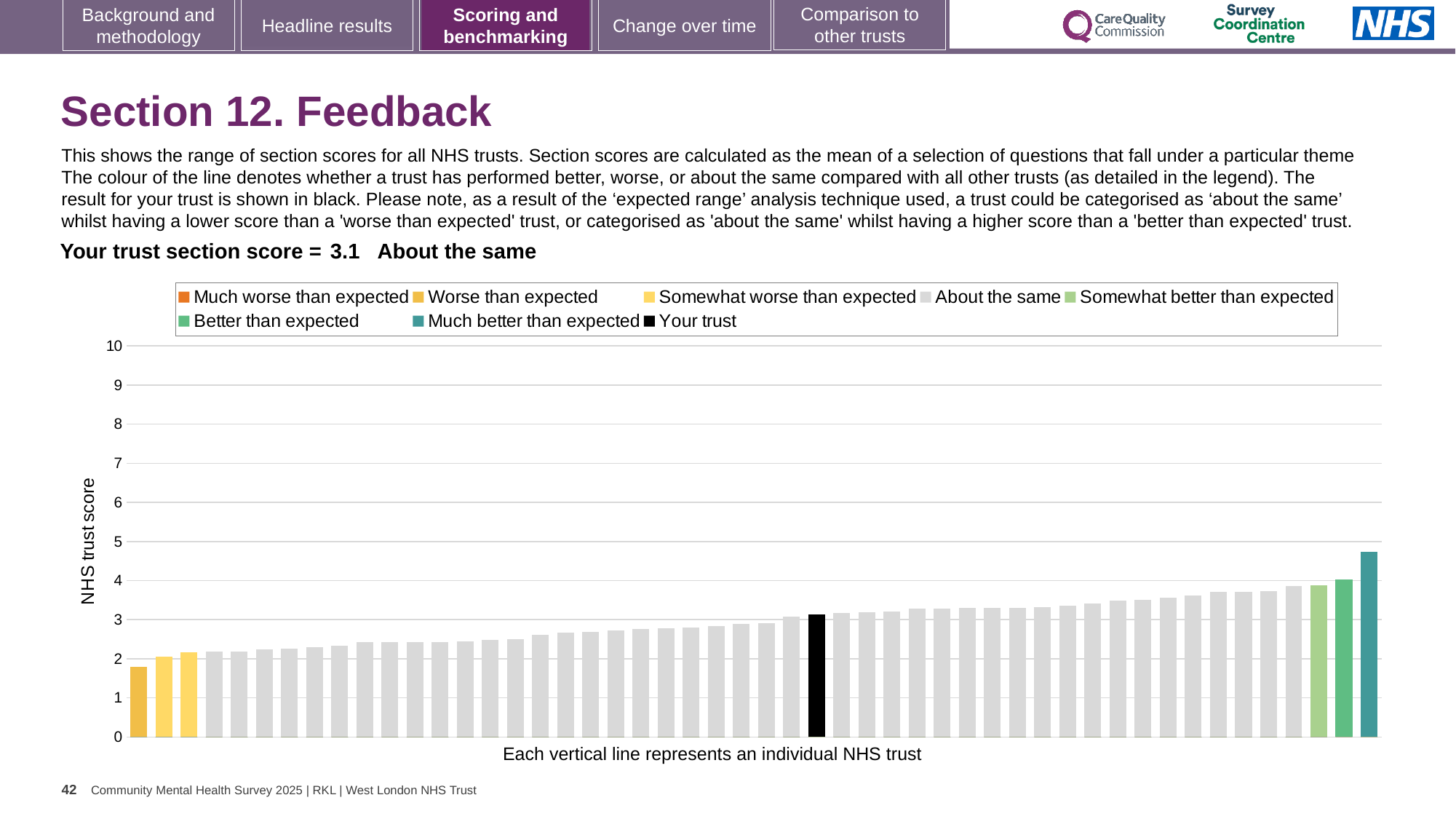
What is the section score for your trust? 3.1 Which category is your trust's section score placed in? About the same What kind of chart is shown on the slide? bar chart Is the value of the tallest bar (Much better than expected) greater or less than 4? greater Is the value of the tallest bar (Much better than expected) greater or less than 5? less What is the label on the vertical axis of the chart? NHS trust score How many entries does the chart legend list? 8 Do the bar values rise or fall from left to right along the x axis? rise Which is larger: the bar for your trust or the teal 'Much better than expected' bar? Much better than expected Is the value of the shortest bar on the far left greater or less than 2? less Which legend category does the tallest bar belong to? Much better than expected